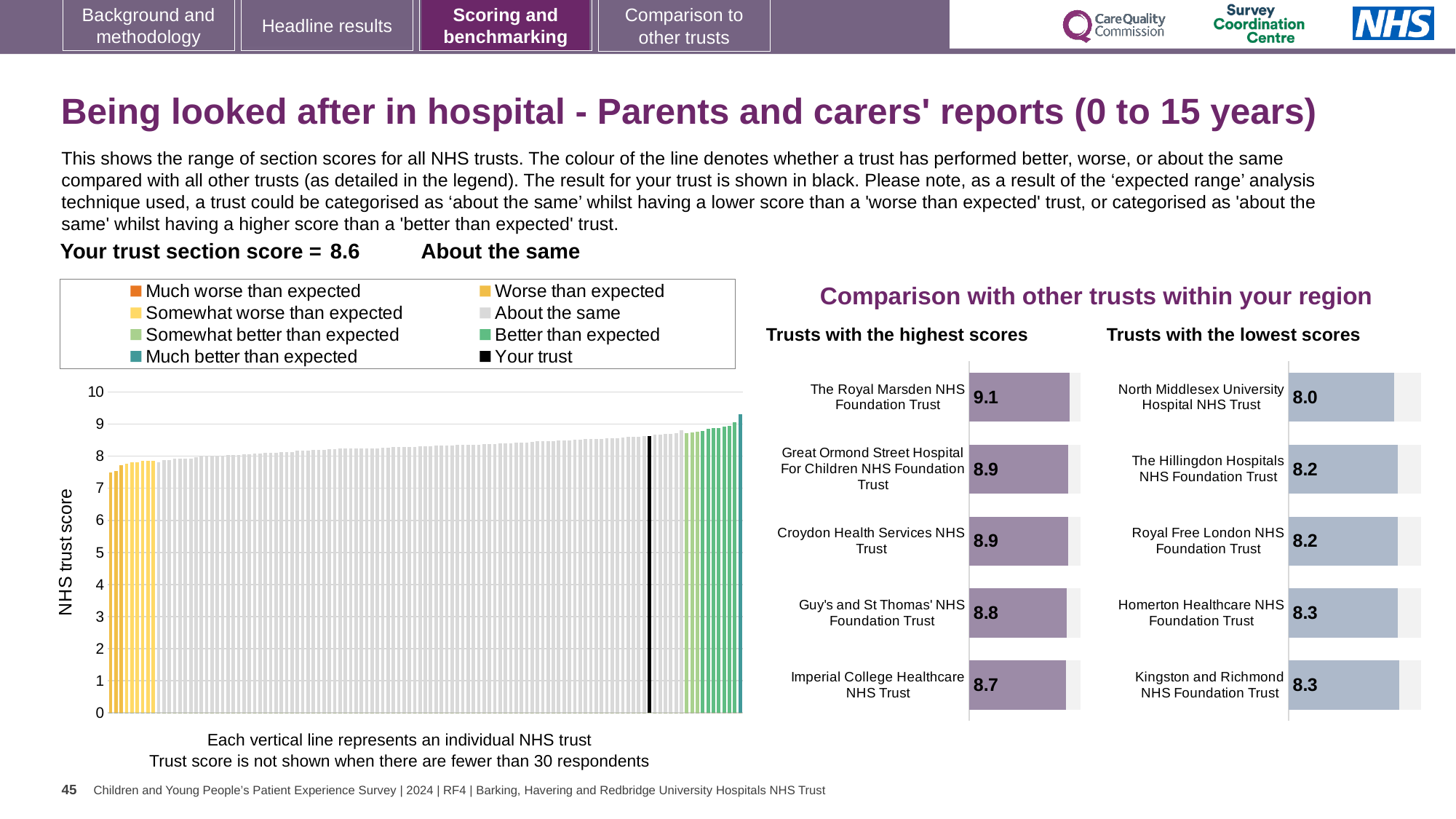
How many entries does the legend of the large chart on the left list? 8 In the 'Trusts with the lowest scores' chart, which trust has the lowest score? North Middlesex University Hospital NHS Trust In the large chart on the left, what is the section score for your trust (the black bar)? 8.6 How many trusts are shown in the 'Trusts with the highest scores' chart? 5 In the 'Trusts with the lowest scores' chart, what is the score for Kingston and Richmond NHS Foundation Trust? 8.3 What kind of chart is the large chart on the left showing NHS trust scores? Bar chart In the 'Trusts with the highest scores' chart, which trust has the highest score? The Royal Marsden NHS Foundation Trust In the 'Trusts with the highest scores' chart, what is the difference between the scores of The Royal Marsden NHS Foundation Trust and Imperial College Healthcare NHS Trust? 0.4 In the 'Trusts with the highest scores' chart, what is the score for The Royal Marsden NHS Foundation Trust? 9.1 In the 'Trusts with the lowest scores' chart, which has the larger score: The Hillingdon Hospitals NHS Foundation Trust or Homerton Healthcare NHS Foundation Trust? Homerton Healthcare NHS Foundation Trust In the 'Trusts with the lowest scores' chart, what is the score for North Middlesex University Hospital NHS Trust? 8.0 In the 'Trusts with the highest scores' chart, what is the score for Guy's and St Thomas' NHS Foundation Trust? 8.8